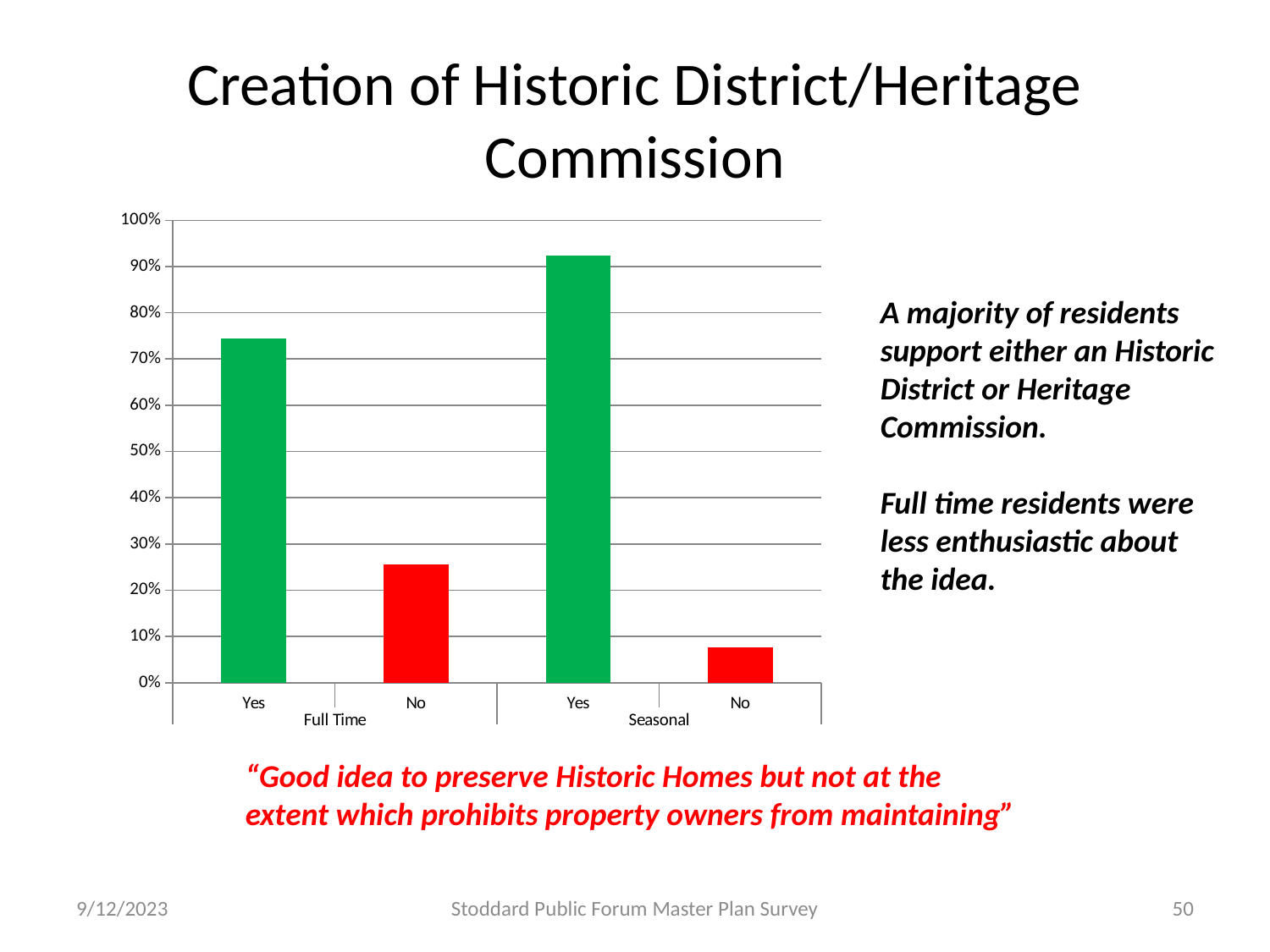
Is the value for Seasonal No greater or less than 10%? less Is the value for Full Time Yes greater or less than 70%? greater What colour are the Yes bars in the chart? green What kind of chart is shown on the slide? bar chart Which is larger, the No value for Full Time or the No value for Seasonal? Full Time Which bar is the shortest in the chart? Seasonal No Is the value for Full Time No greater or less than 30%? less What are the two resident groups shown on the x axis of the chart? Full Time and Seasonal Which is larger, the Yes value for Full Time or the Yes value for Seasonal? Seasonal Which bar is the tallest in the chart? Seasonal Yes How many bars are plotted in the chart? 4